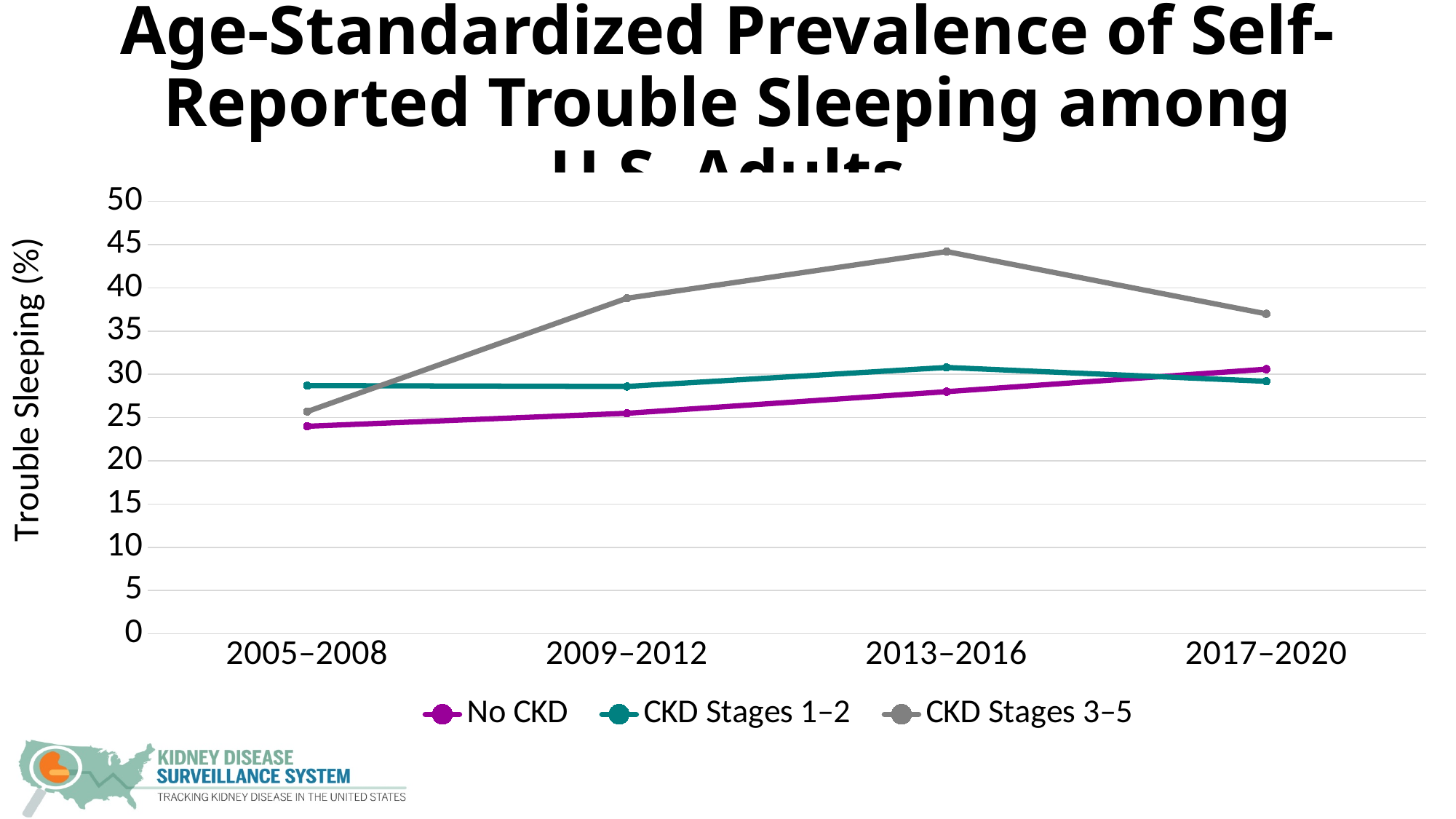
What kind of chart is shown on the slide? line chart Is the value for CKD Stages 1–2 in 2005–2008 greater or less than 30? less In which period is the value for No CKD lowest? 2005–2008 How many series does the legend list? 3 In 2005–2008, which is larger: the value for No CKD or the value for CKD Stages 1–2? CKD Stages 1–2 Does the No CKD series rise or fall from 2005–2008 to 2017–2020? rise In which period is the value for CKD Stages 3–5 highest? 2013–2016 How many time periods are shown on the x axis? 4 Is the value for CKD Stages 3–5 in 2009–2012 greater or less than 35? greater Is the value for No CKD in 2005–2008 greater or less than 25? less Which series has the highest value in 2013–2016? CKD Stages 3–5